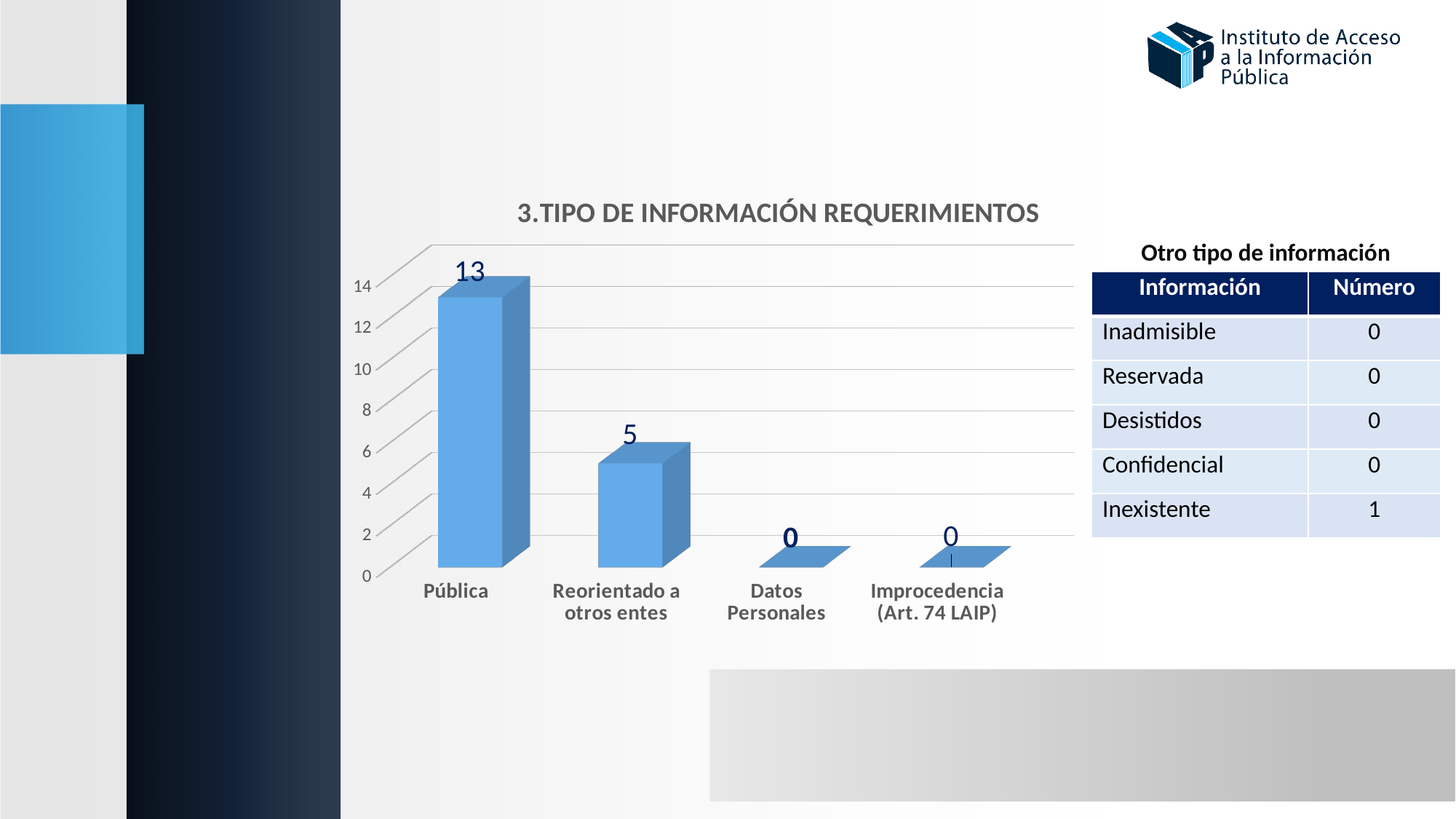
What is the value for Datos Personales in the chart? 0 Which is larger, the value for Pública or the value for Reorientado a otros entes? Pública What is the value for Improcedencia (Art. 74 LAIP) in the chart? 0 Which category has the highest value in the chart? Pública Is the value for Pública greater or less than 10? greater What is the value for Reorientado a otros entes in the chart? 5 How many categories are shown on the x axis of the chart? 4 What is the value for Pública in the chart? 13 What is the difference between the values for Pública and Reorientado a otros entes? 8 What is the title of the chart? 3.TIPO DE INFORMACIÓN REQUERIMIENTOS Do the values rise or fall from left to right along the x axis? fall What kind of chart is shown on the slide? bar chart